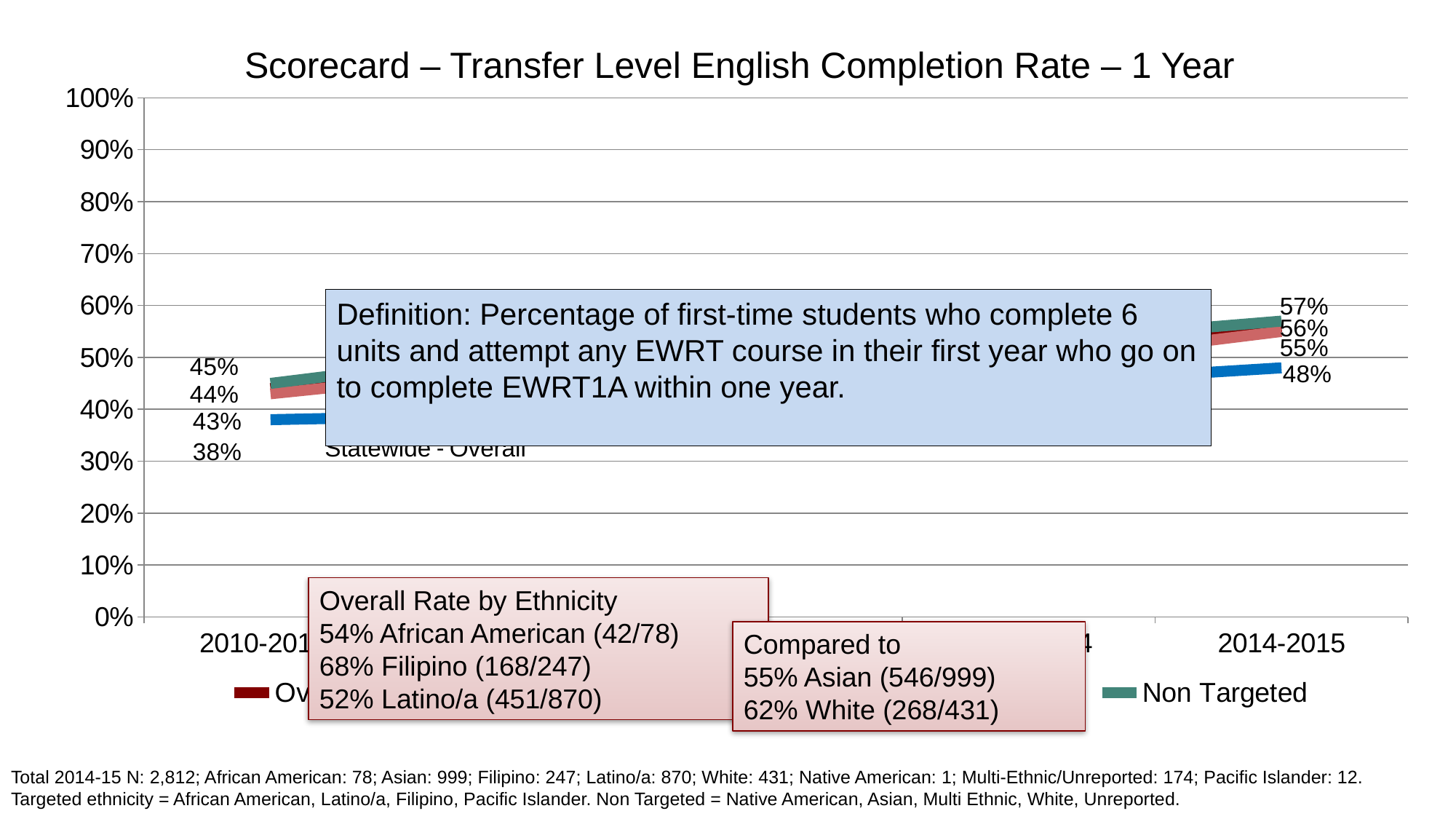
What is the lowest data label shown for 2010-2011? 38% What is the difference between the highest label in 2014-2015 and the highest label in 2010-2011? 12 percentage points Is the lowest plotted value in 2010-2011 greater or less than 40%? less What is the highest data label shown for 2010-2011? 45% What is the difference between the lowest label in 2014-2015 and the lowest label in 2010-2011? 10 percentage points What is the highest data label shown for 2014-2015? 57% What is the lowest data label shown for 2014-2015? 48% What colour is the Non Targeted series in the legend? green What kind of chart is shown on the slide? line chart Do the plotted values rise or fall from 2010-2011 to 2014-2015? rise Is the value of the Non Targeted line in 2014-2015 greater or less than 50%? greater What is the title of the chart? Scorecard – Transfer Level English Completion Rate – 1 Year